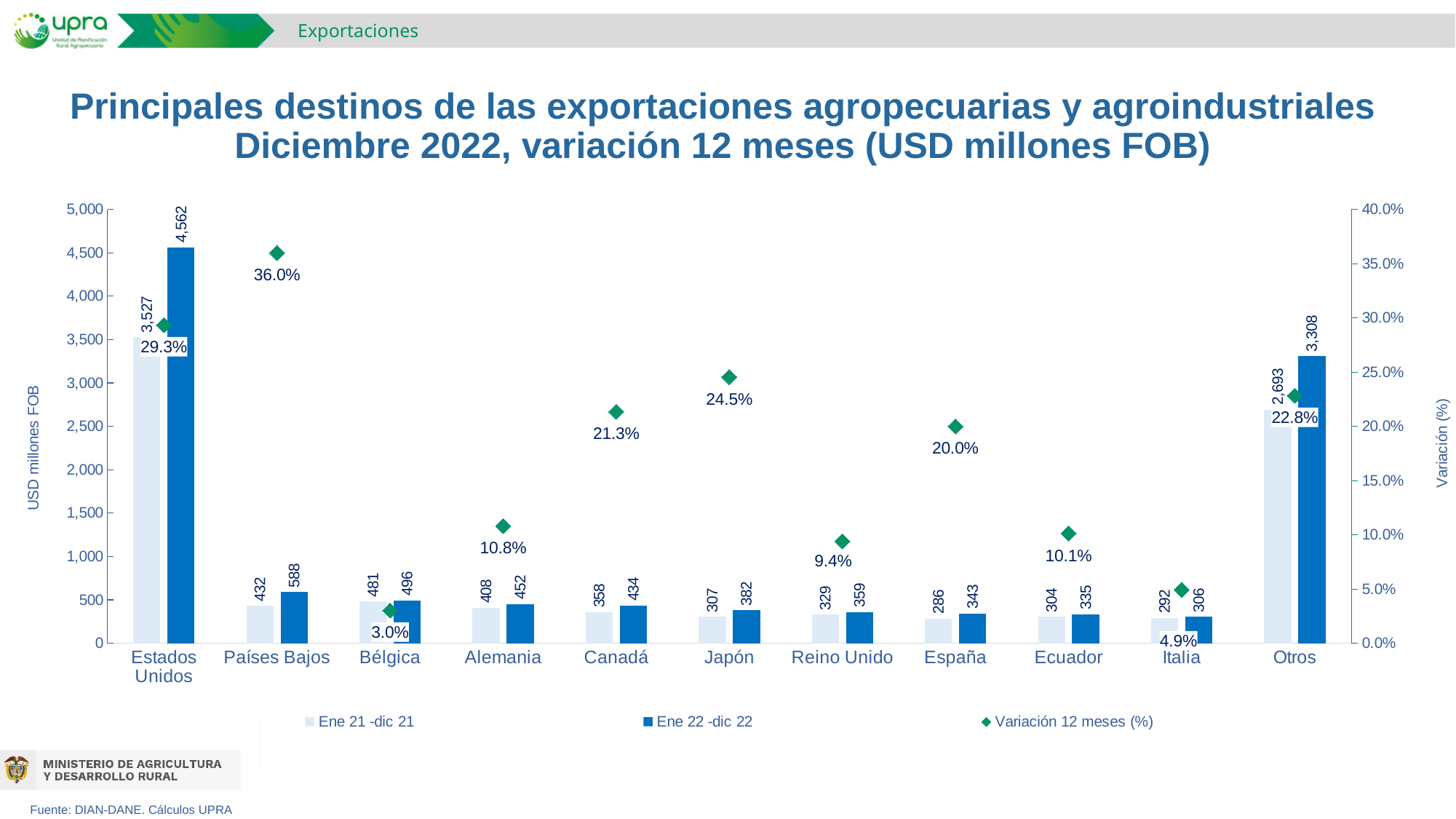
What is the difference between the Ene 22 -dic 22 and Ene 21 -dic 21 values for Japón? 75 What is the Variación 12 meses (%) value for Canadá? 21.3% What is the Ene 22 -dic 22 value for Estados Unidos? 4,562 Which category has the lowest Variación 12 meses (%)? Bélgica What is the Ene 21 -dic 21 value for Países Bajos? 432 How many series does the legend list? 3 How many destination categories are shown on the x axis? 11 Is the Ene 22 -dic 22 value for Otros greater or less than 3,000? greater What kind of chart is used for the Ene 21 -dic 21 and Ene 22 -dic 22 series? Bar chart Which is larger, the Ene 22 -dic 22 value for Alemania or for Canadá? Alemania Which country has the highest Variación 12 meses (%)? Países Bajos What is the label of the left vertical axis? USD millones FOB